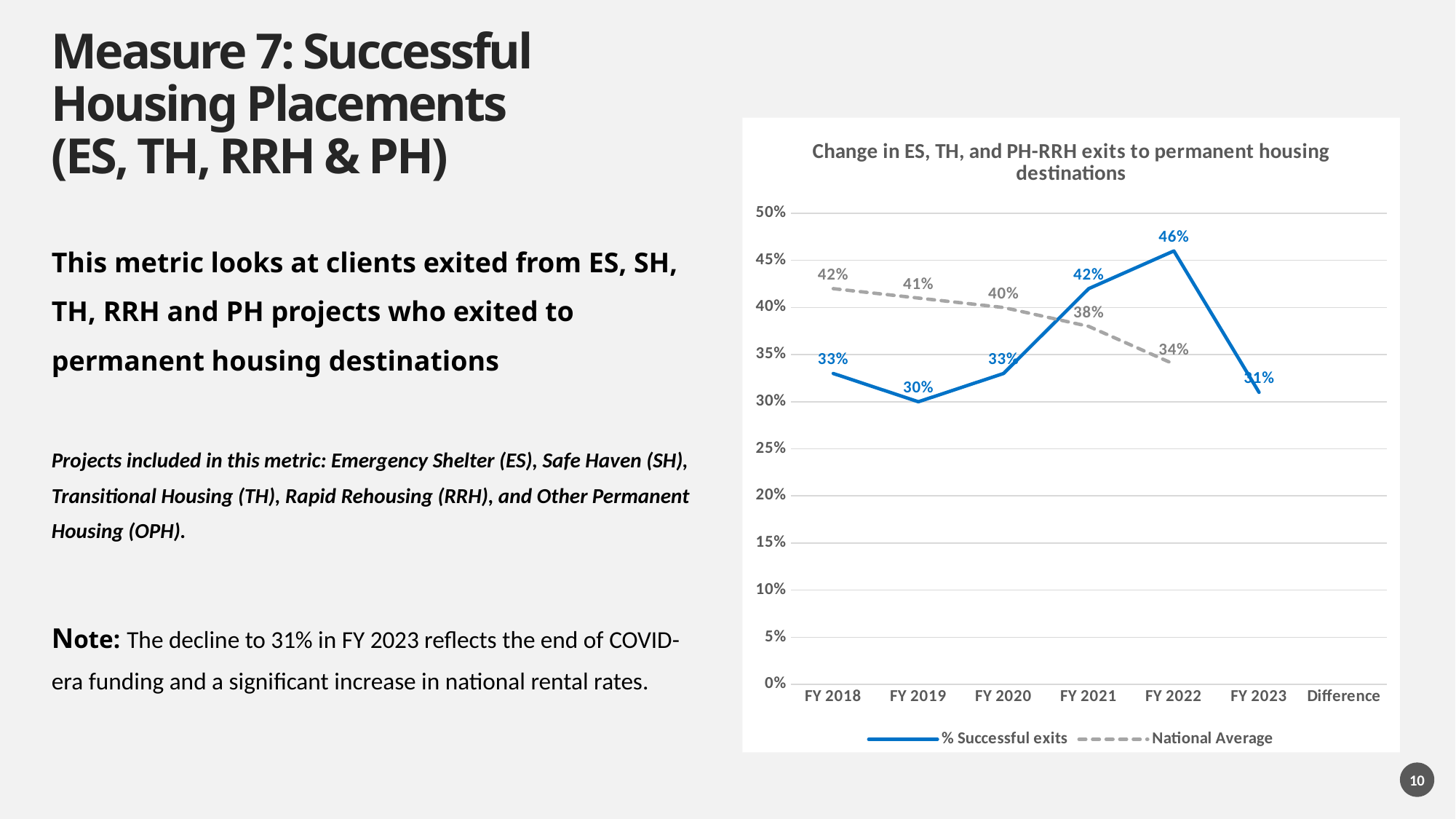
What type of chart is shown on the slide? line chart For FY 2021, which is larger: % Successful exits or National Average? % Successful exits What is the % Successful exits value for FY 2022? 46% What is the title of the chart? Change in ES, TH, and PH-RRH exits to permanent housing destinations What is the National Average value for FY 2020? 40% How many series does the legend list? 2 What is the % Successful exits value for FY 2019? 30% In which fiscal year is the % Successful exits value lowest? FY 2019 What is the difference between the National Average and % Successful exits values for FY 2018? 9% Does the National Average series rise or fall from FY 2018 to FY 2022? fall In which fiscal year is the % Successful exits value highest? FY 2022 What is the difference between the % Successful exits values for FY 2022 and FY 2023? 15%